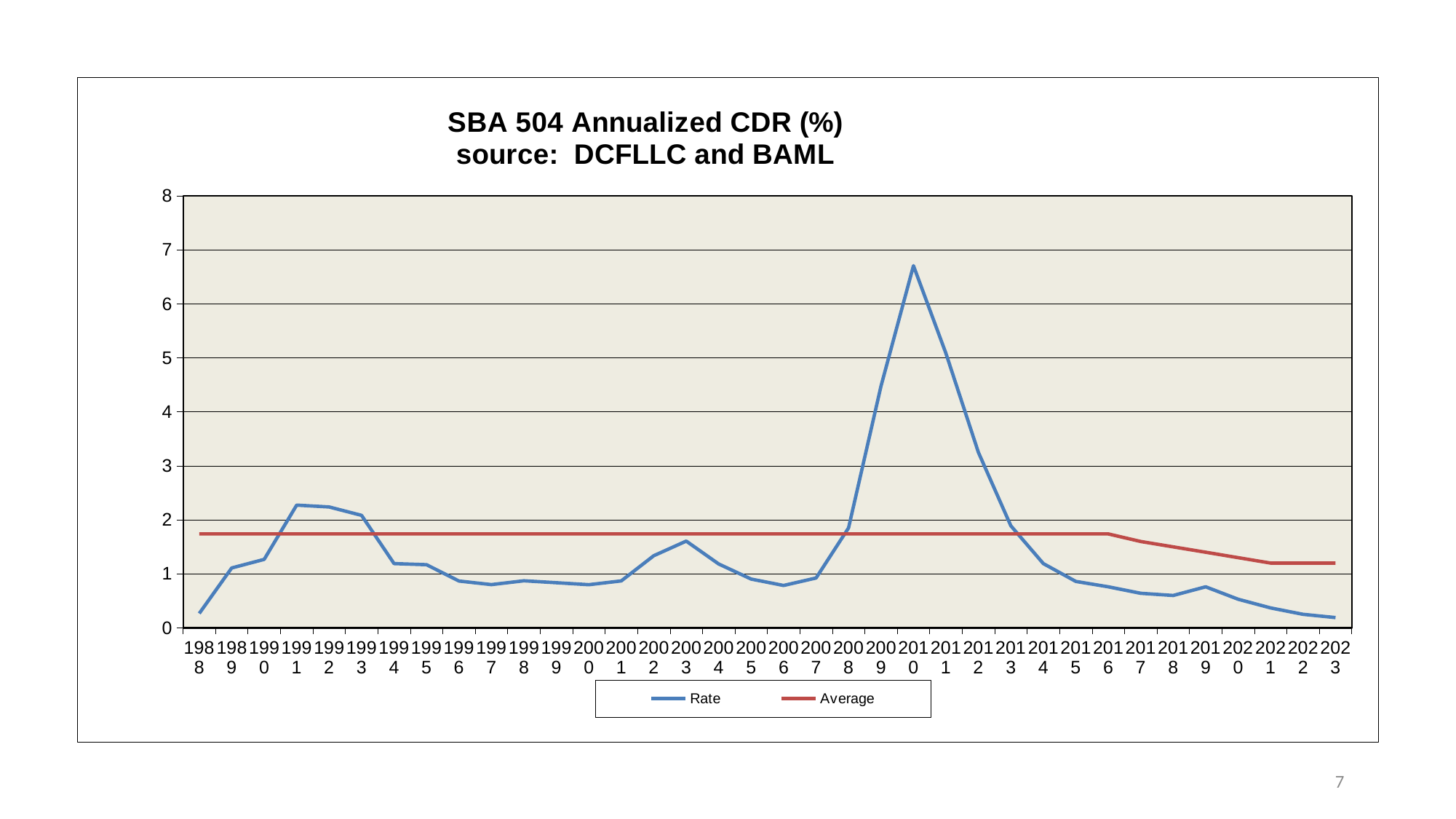
Is the Rate value for 2010 greater or less than 6? greater Is the Rate value for 2006 greater or less than 1? less How many years are plotted along the x axis? 36 What are the names of the series in the legend? Rate and Average In which year does the Rate series reach its highest value? 2010 Is the Rate value for 2023 greater or less than 1? less Which year has the larger Rate value, 2003 or 2010? 2010 How many series does the legend list? 2 Does the Rate series rise or fall from 2010 to 2013? fall What is the title of the chart? SBA 504 Annualized CDR (%) source: DCFLLC and BAML What kind of chart is shown on the slide? line chart